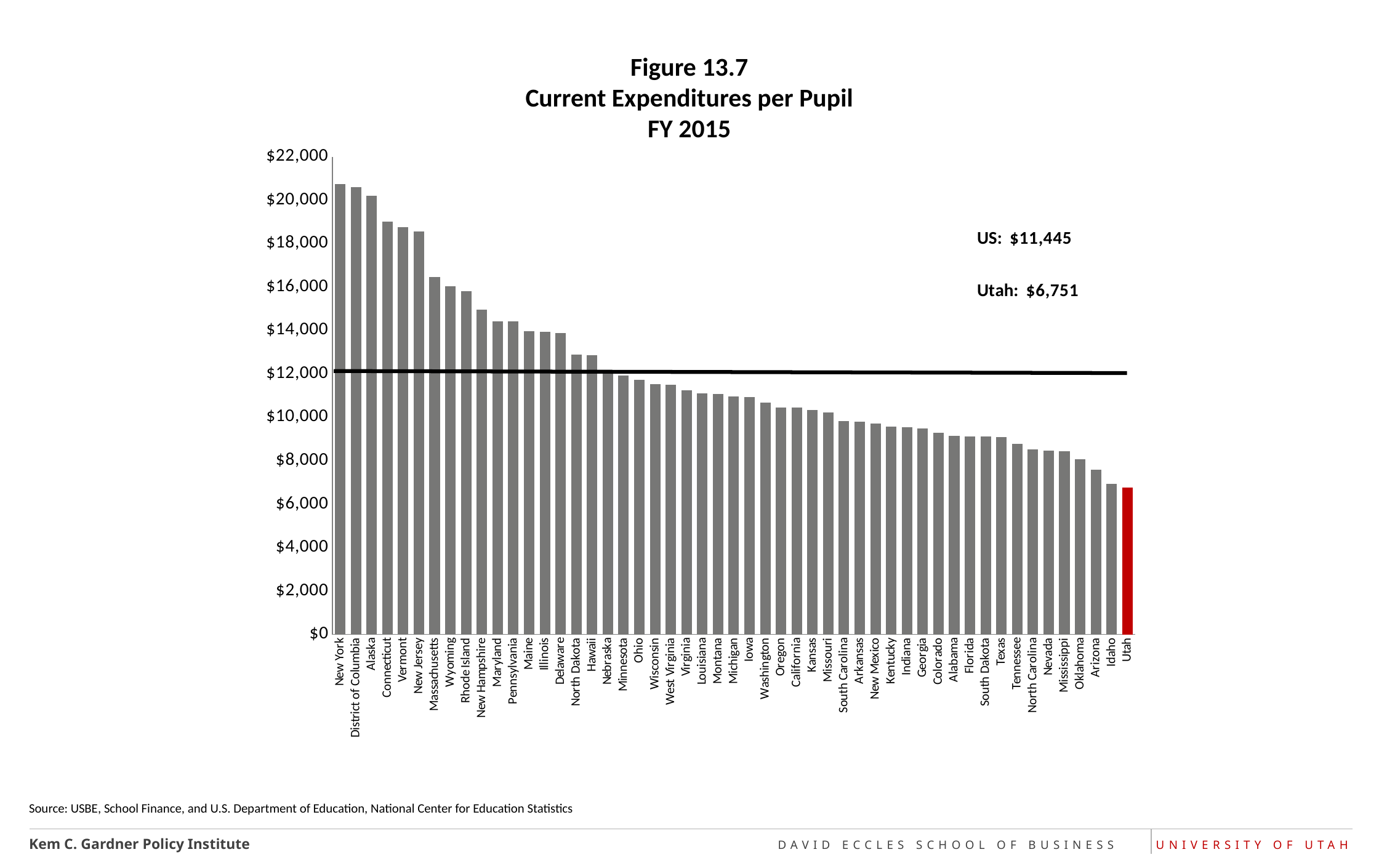
Which bar is highlighted in red? Utah Which state has the highest current expenditures per pupil in FY 2015? New York What is the difference between the US value and the Utah value printed on the slide? $4,694 How many states/jurisdictions are shown as bars in the chart? 51 Is the value for Connecticut greater or less than $20,000? less Is the value for Arizona greater or less than $8,000? less Which state has the lowest current expenditures per pupil in FY 2015? Utah Which has higher expenditures per pupil, Maryland or Texas? Maryland What is Utah's current expenditure per pupil as printed on the slide? $6,751 Is the value for New York greater or less than $20,000? greater What kind of chart is shown on the slide? bar chart What is the US current expenditure per pupil as printed on the slide? $11,445